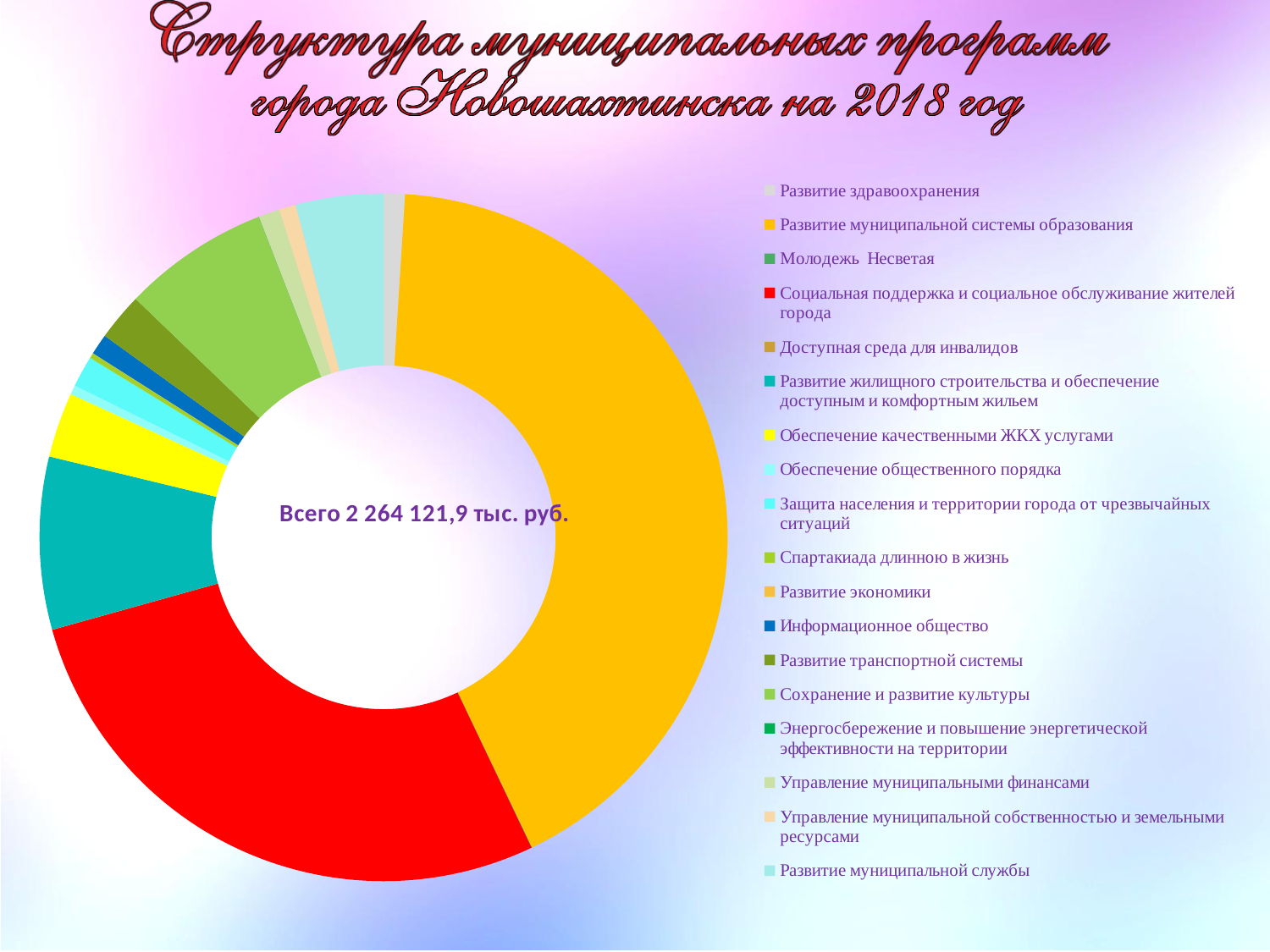
What total is printed in the centre of the chart? Всего 2 264 121,9 тыс. руб. What kind of chart is shown on the slide? Doughnut (pie) chart Which category has the second-largest share of the chart? Социальная поддержка и социальное обслуживание жителей города Which is larger: the share for 'Развитие жилищного строительства и обеспечение доступным и комфортным жильем' or the share for 'Обеспечение качественными ЖКХ услугами'? Развитие жилищного строительства и обеспечение доступным и комфортным жильем Which is larger: the share for 'Сохранение и развитие культуры' or the share for 'Информационное общество'? Сохранение и развитие культуры Which is larger: the share for 'Развитие муниципальной системы образования' or the share for 'Социальная поддержка и социальное обслуживание жителей города'? Развитие муниципальной системы образования What is the title of the slide containing the chart? Структура муниципальных программ города Новошахтинска на 2018 год How many categories does the legend of the chart list? 18 Which category has the largest share of the chart? Развитие муниципальной системы образования